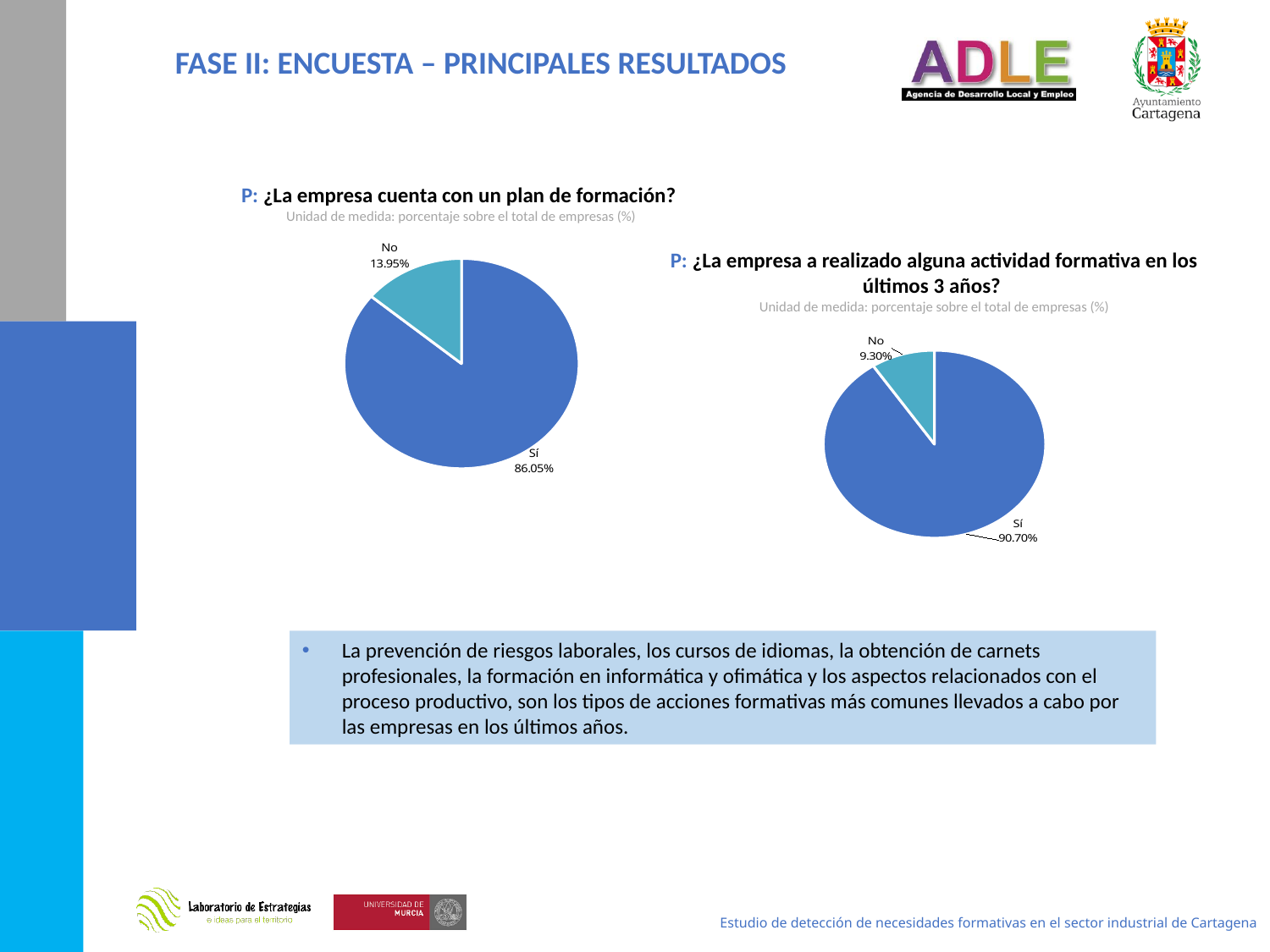
In the right pie chart, which category has the smallest slice? No Which is larger: the No share in the left pie chart or the No share in the right pie chart? The No share in the left pie chart What type of chart is used on the right side of the slide? Pie chart In the left pie chart, which category has the largest slice? Sí In the right pie chart (¿La empresa a realizado alguna actividad formativa en los últimos 3 años?), what percentage answered No? 9.30% In the right pie chart, what colour is the Sí slice? Blue In the right pie chart (¿La empresa a realizado alguna actividad formativa en los últimos 3 años?), what percentage answered Sí? 90.70% What is the unit of measure stated under the left chart's title? Porcentaje sobre el total de empresas (%) In the left pie chart (¿La empresa cuenta con un plan de formación?), what percentage of companies answered No? 13.95% In the left pie chart, what is the difference in percentage points between Sí and No? 72.10 How many slices does the left pie chart have? 2 In the left pie chart (¿La empresa cuenta con un plan de formación?), what percentage of companies answered Sí? 86.05%